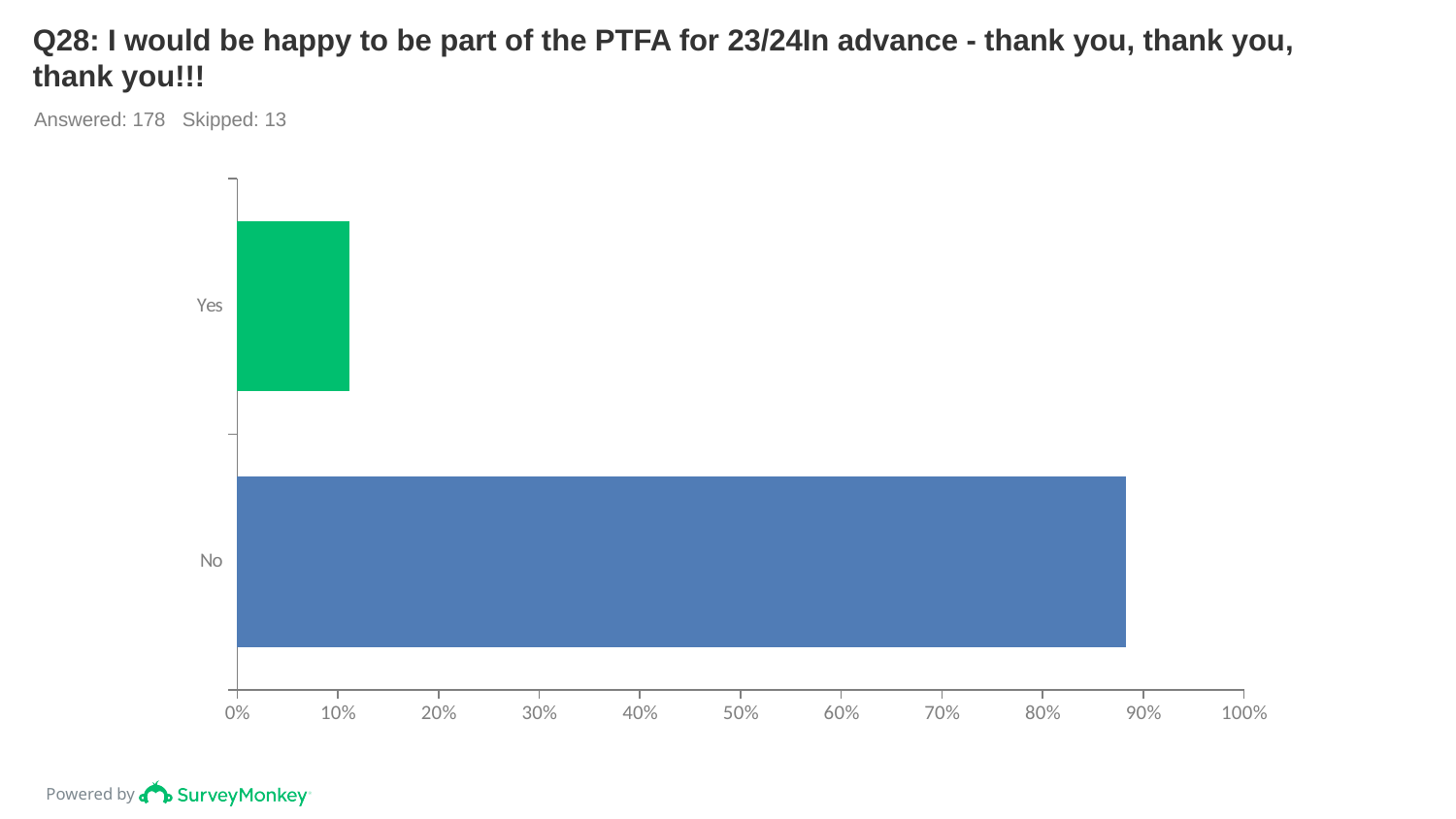
Is the value for Yes greater or less than 20%? less Is the value for Yes greater or less than 30%? less Is the value for No greater or less than 80%? greater Which category has the lowest value? Yes What colour is the bar for Yes? green How many categories are plotted in the chart? 2 Which is larger, the value for Yes or the value for No? No Which category has the highest value? No What is the highest value shown on the x axis? 100% What kind of chart is shown on the slide? bar chart